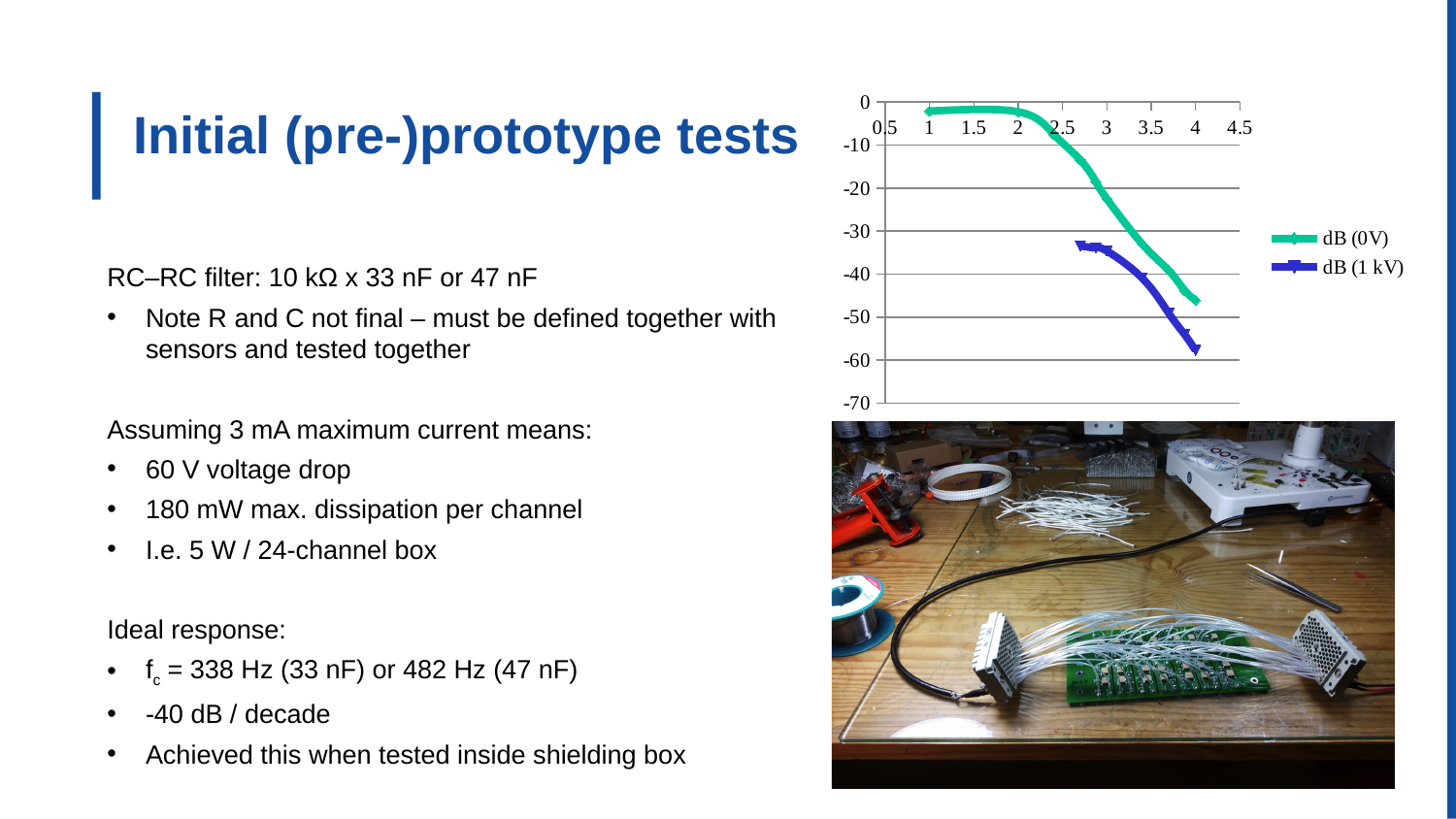
At x = 3.5, which series has the higher (less negative) value, dB (0V) or dB (1 kV)? dB (0V) Which colour is used for the dB (1 kV) series in the chart? blue What kind of chart is shown on the slide? line chart How many series does the chart legend list? 2 Is the value for dB (0V) at x = 1 greater or less than -10? greater Is the value for dB (1 kV) at x = 4 greater or less than -50? less What is the lowest value shown on the chart's vertical axis? -70 Is the value for dB (0V) at x = 4 greater or less than -40? less What are the two series named in the chart legend? dB (0V) and dB (1 kV) Do the values of the dB (0V) series rise or fall as the x axis increases? fall Do the values of the dB (1 kV) series rise or fall as the x axis increases? fall